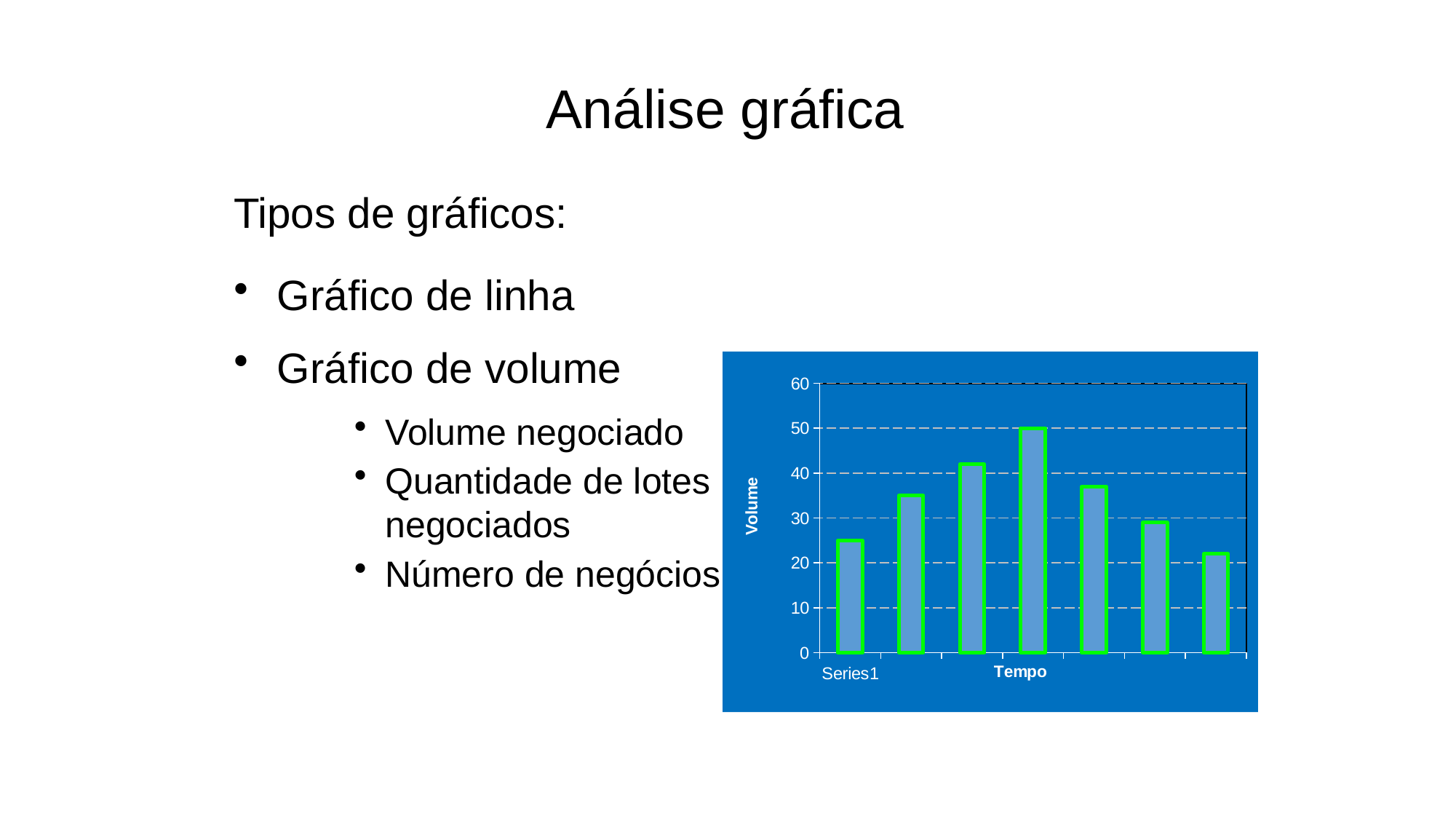
Which bar is the tallest in the chart? the fourth bar What is the title of the vertical axis of the chart? Volume How many bars are plotted in the chart? 7 What kind of chart is shown on the slide? bar chart Is the value of the first bar (labelled Series1) greater or less than 30? less Do the bar values rise or fall from the fourth bar to the last bar? fall Which is larger, the second bar or the fifth bar? the fifth bar What is the title of the horizontal axis of the chart? Tempo Is the value of the third bar greater or less than 40? greater Is the value of the second bar greater or less than 30? greater Which bar is the shortest in the chart? the seventh (last) bar